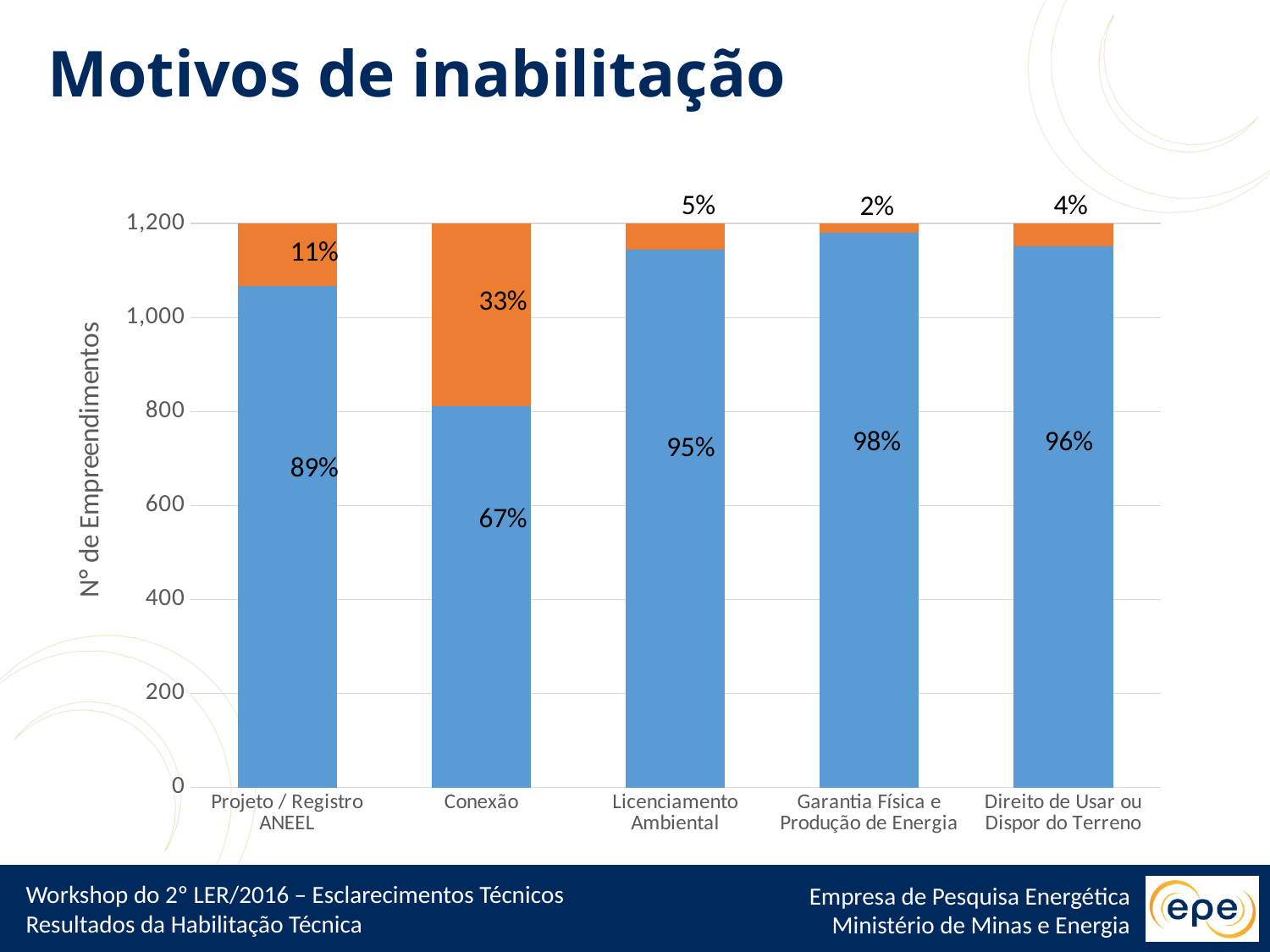
What percentage is shown for the blue segment of the Licenciamento Ambiental bar? 95% What percentage is shown for the orange segment of the Projeto / Registro ANEEL bar? 11% What is the difference in percentage points between the blue share of Garantia Física e Produção de Energia and the blue share of Conexão? 31 percentage points Which has a larger orange share, Licenciamento Ambiental or Direito de Usar ou Dispor do Terreno? Licenciamento Ambiental How many categories are shown on the x axis? 5 What percentage is shown for the blue segment of the Garantia Física e Produção de Energia bar? 98% Is the blue segment of the Conexão bar greater or less than 1,000 on the y axis? less What percentage is shown for the orange segment of the Conexão bar? 33% Which category has the largest orange share? Conexão What is the y-axis label of the chart? N° de Empreendimentos What kind of chart is shown on the slide? Stacked bar chart Which category has the smallest orange share? Garantia Física e Produção de Energia